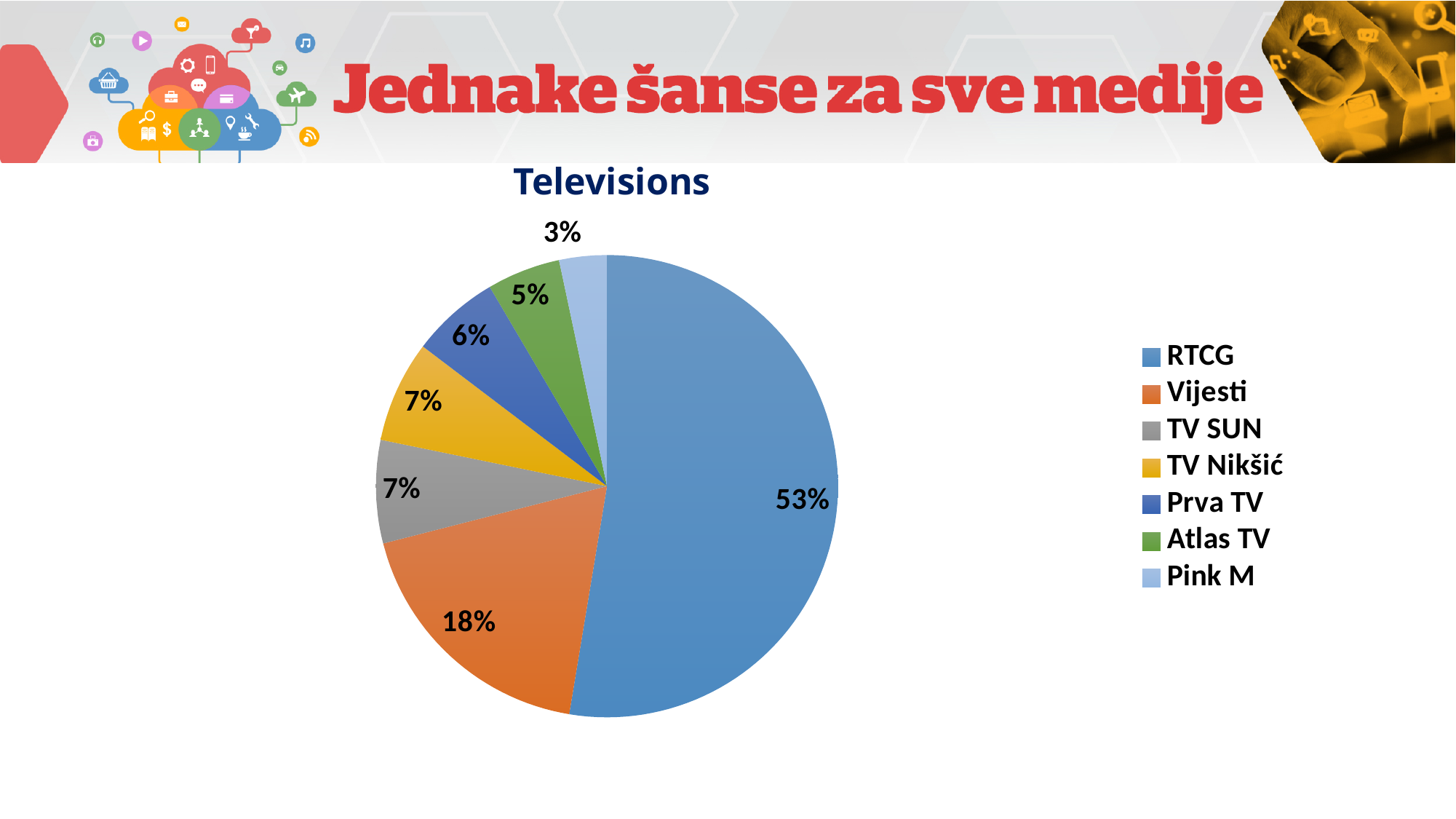
What is the title of the chart? Televisions What type of chart is shown on the slide? pie chart What colour is the slice for Atlas TV? green How many categories does the legend list? 7 What share of the pie does RTCG have? 53% What is the value shown for Prva TV? 6% What is the difference between the shares of RTCG and Vijesti? 35% What is the value shown for Atlas TV? 5% Which is larger, the share for Vijesti or the share for TV Nikšić? Vijesti Which category has the largest slice of the pie? RTCG Which category has the smallest slice of the pie? Pink M What is the value shown for Vijesti? 18%